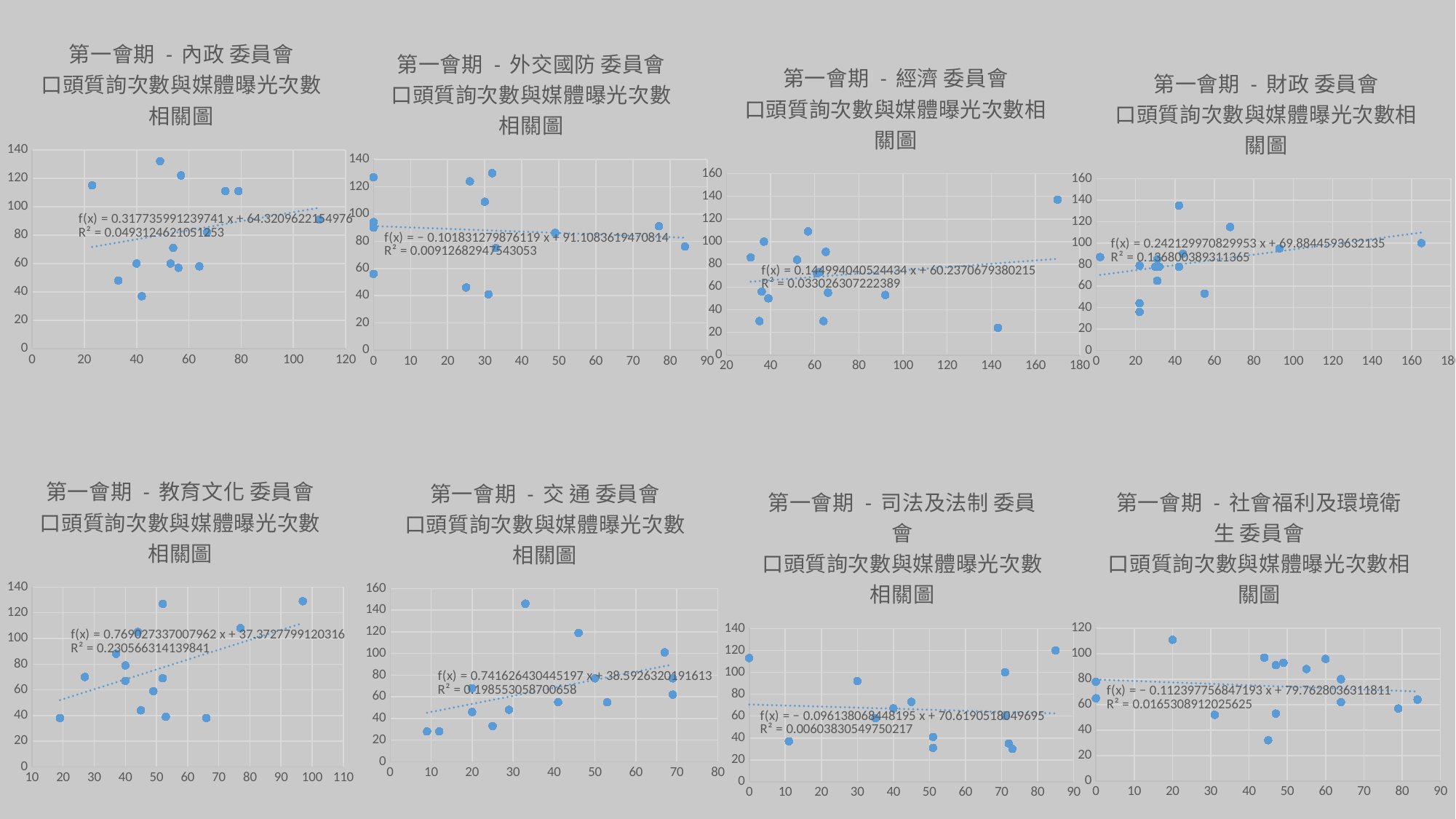
In the 第一會期 - 交通 委員會 chart, what is the trendline equation printed on the chart? f(x) = 0.741626430445197 x + 38.5926320191613 In the 第一會期 - 司法及法制 委員會 chart, what is the R² value printed on the chart? R² = 0.00603830549750217 In the 第一會期 - 財政 委員會 chart, what is the trendline equation printed on the chart? f(x) = 0.242129970829953 x + 69.8844593632135 Across the eight charts, which committee's chart shows the highest R² value? 教育文化 委員會 Across the eight charts, which committee's chart shows the lowest R² value? 司法及法制 委員會 How many charts are shown on the slide? 8 In the 第一會期 - 教育文化 委員會 chart, does the trendline rise or fall as x increases? rise In the 第一會期 - 交通 委員會 chart, is the highest plotted point greater or less than 140? greater What kind of chart is used for the 第一會期 - 內政 委員會 chart? scatter chart In the 第一會期 - 外交國防 委員會 chart, does the trendline rise or fall as x increases? fall In the 第一會期 - 經濟 委員會 chart, is the lowest plotted point greater or less than 40? less In the 第一會期 - 教育文化 委員會 chart, what is the R² value printed on the chart? R² = 0.230566314139841